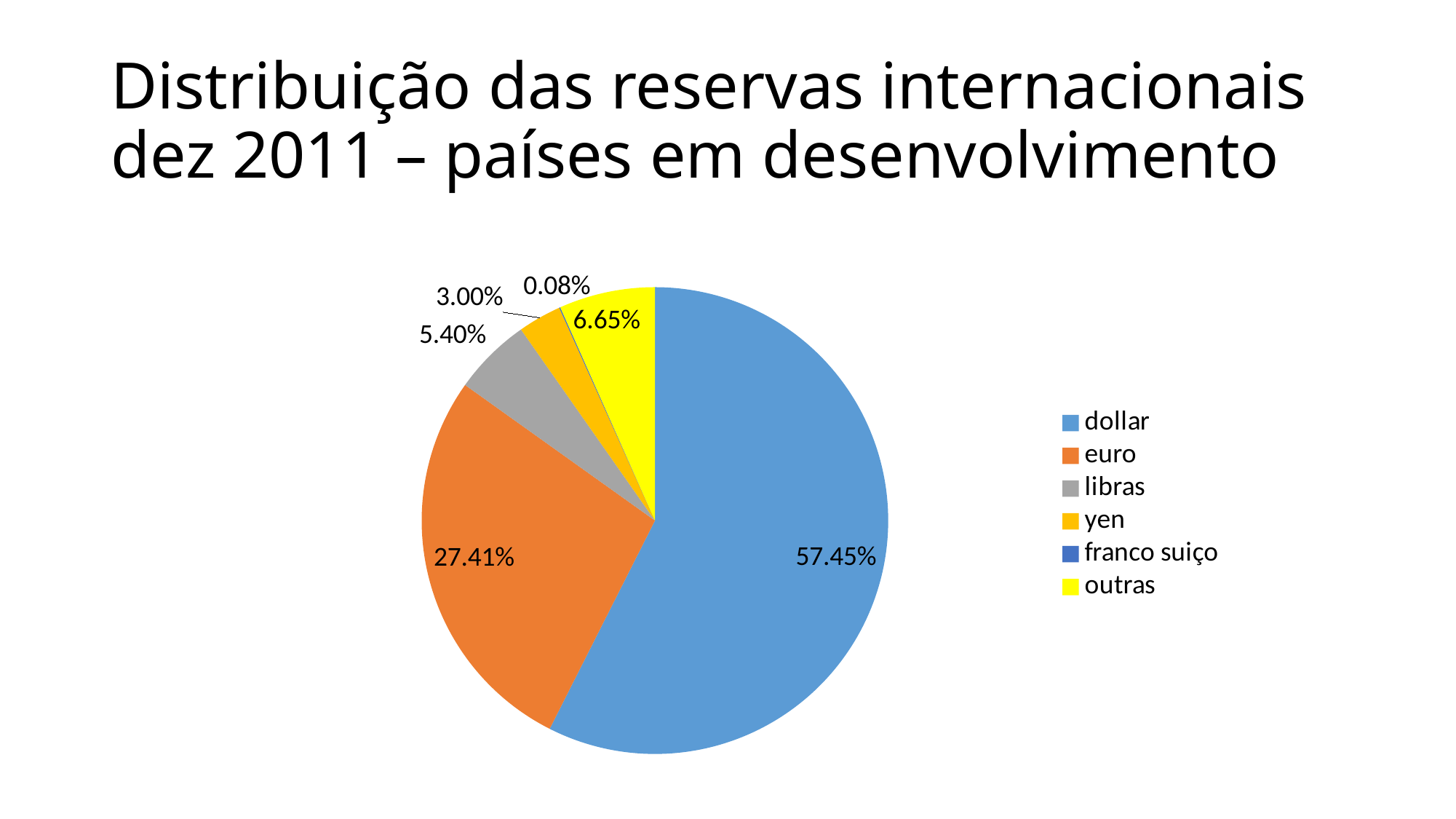
How many categories does the legend list? 6 Which is larger, the share for outras or the share for libras? outras What percentage is shown for libras? 5.40% What kind of chart is shown on the slide? pie chart What is the value for yen? 3.00% Which category has the largest slice of the pie? dollar What share of the pie does dollar hold? 57.45% Which category has the smallest slice of the pie? franco suiço What is the difference between the dollar share and the euro share? 30.04% What colour is the slice for outras? yellow What share is shown for franco suiço? 0.08% What is the value shown for euro? 27.41%